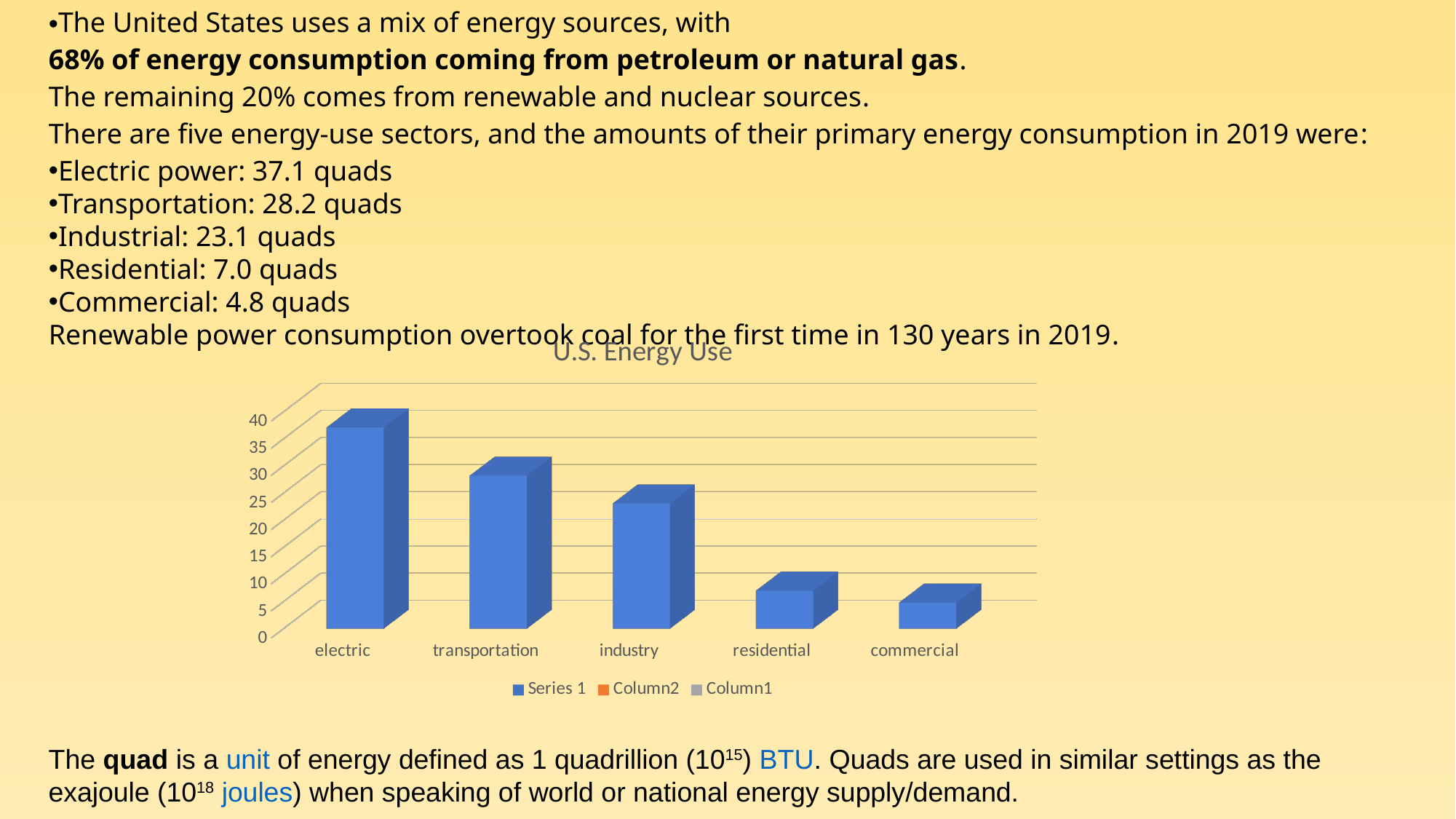
Is the bar for transportation greater or less than 25 in the U.S. Energy Use chart? greater Which category has the lowest bar in the U.S. Energy Use chart? commercial What is the title of the chart on the slide? U.S. Energy Use How many categories are shown on the x axis of the U.S. Energy Use chart? 5 Is the bar for electric greater or less than 35 in the U.S. Energy Use chart? greater What kind of chart is shown under the title "U.S. Energy Use"? bar chart How many series does the legend of the U.S. Energy Use chart list? 3 Is the bar for industry greater or less than 25 in the U.S. Energy Use chart? less Which category has the highest bar in the U.S. Energy Use chart? electric Do the bars in the U.S. Energy Use chart rise or fall from left to right along the x axis? fall Which is larger in the U.S. Energy Use chart, the bar for transportation or the bar for industry? transportation